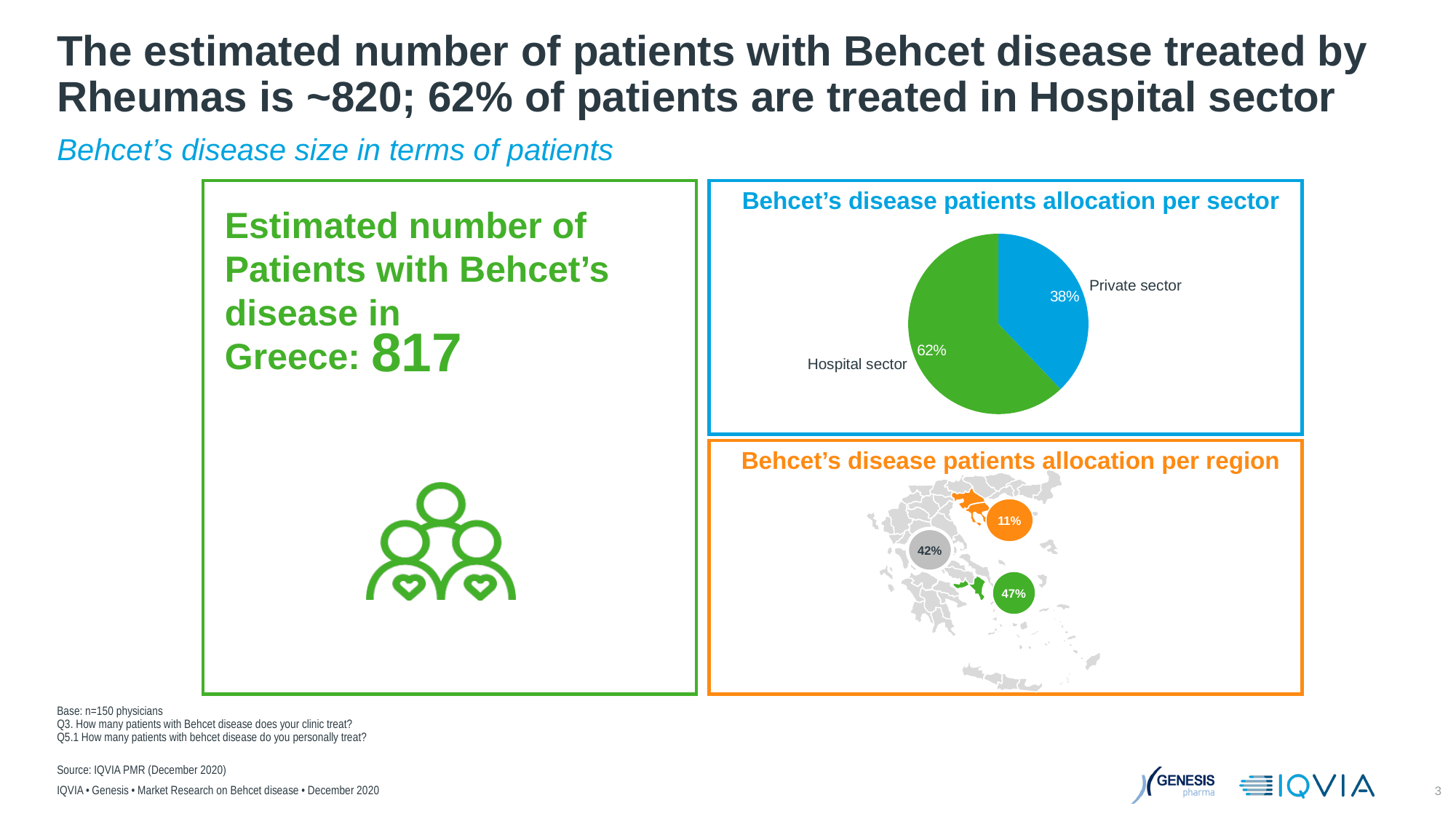
In the 'Behcet's disease patients allocation per region' map, what is the largest regional share shown? 47% In the 'Behcet's disease patients allocation per sector' chart, which sector has the smallest share of patients? Private sector In the 'Behcet's disease patients allocation per sector' chart, what is the difference in percentage points between the Hospital sector and the Private sector shares? 24 percentage points What type of chart is used for 'Behcet's disease patients allocation per sector'? Pie chart In the 'Behcet's disease patients allocation per sector' chart, what share of patients is treated in the Private sector? 38% In the 'Behcet's disease patients allocation per sector' chart, what colour is the Hospital sector slice? Green In the 'Behcet's disease patients allocation per region' map, what is the smallest regional share shown? 11% In the 'Behcet's disease patients allocation per sector' chart, how many sectors are shown? 2 In the 'Behcet's disease patients allocation per sector' chart, what colour is the Private sector slice? Blue In the 'Behcet's disease patients allocation per sector' chart, which sector has the largest share of patients? Hospital sector In the 'Behcet's disease patients allocation per sector' chart, what share of patients is treated in the Hospital sector? 62% In the 'Behcet's disease patients allocation per sector' chart, is the Hospital sector share larger or smaller than the Private sector share? larger